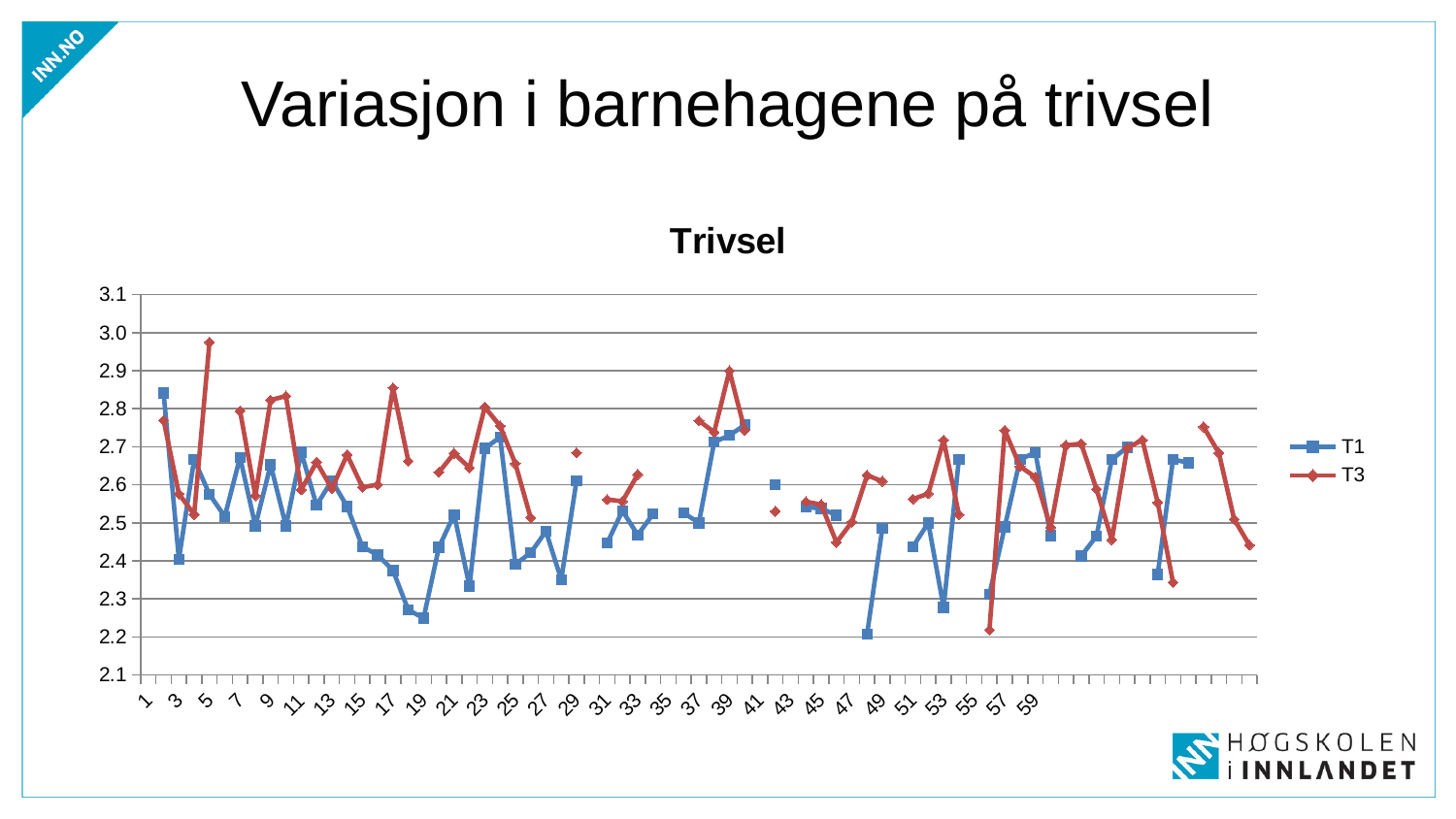
Is the value of T1 at x = 3 greater or less than 2.5? less Which series is drawn in red? T3 At x = 5, which series has the larger value, T1 or T3? T3 Which series reaches the highest value anywhere on the chart? T3 Is the value of T1 at x = 49 greater or less than 2.3? greater What kind of chart is shown on the slide? line chart Is the value of T3 at x = 5 greater or less than 2.9? greater How many series does the legend list? 2 What is the title of the chart? Trivsel